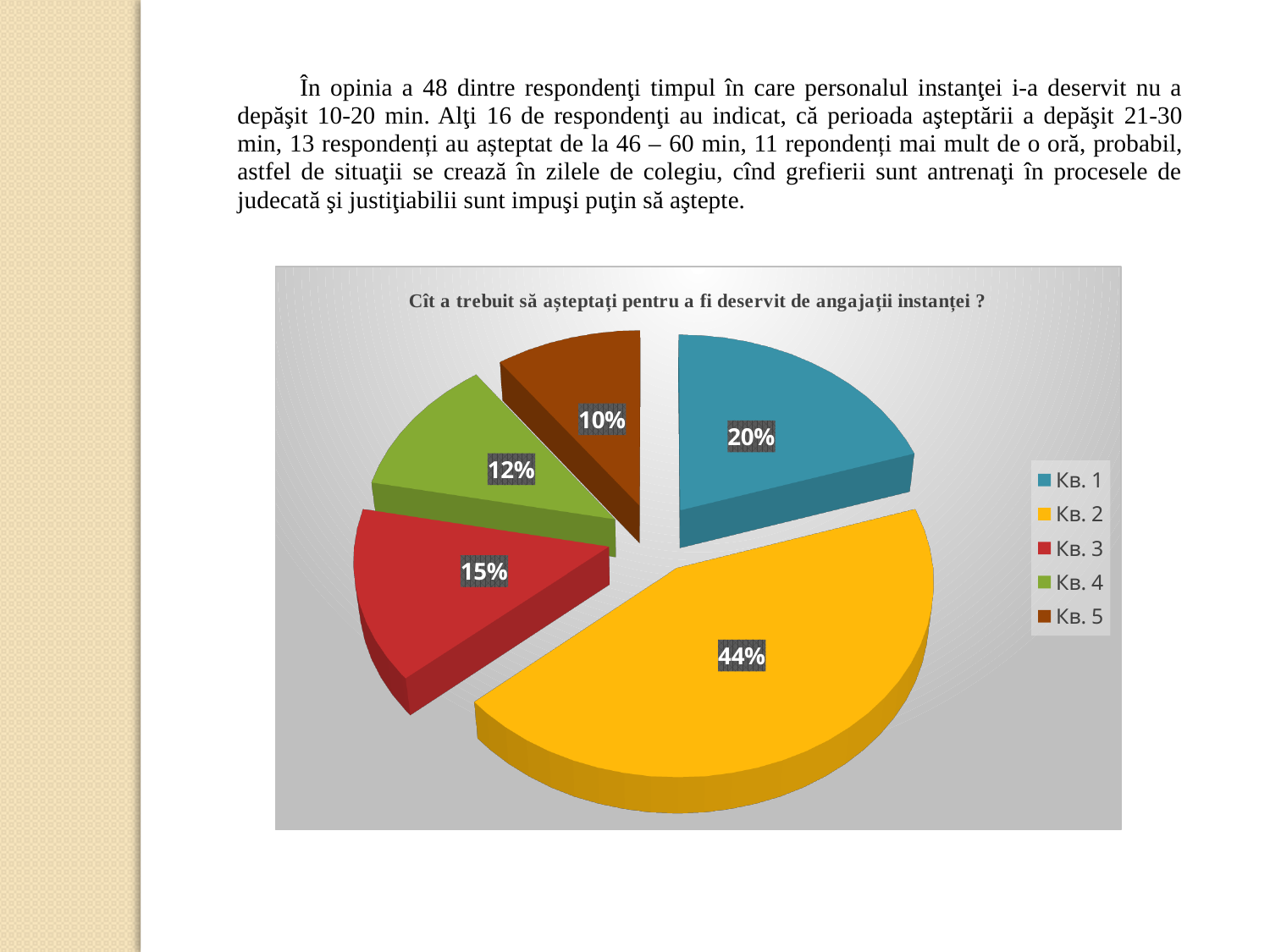
What percentage is shown for Кв. 2? 44% Which category has the smallest share of the pie? Кв. 5 Which category has the largest share of the pie? Кв. 2 What percentage is shown for Кв. 5? 10% How many entries does the legend list? 5 What is the title of the chart? Cît a trebuit să așteptați pentru a fi deservit de angajații instanței ? What is the difference in percentage points between Кв. 2 and Кв. 1? 24 What percentage is shown for Кв. 3? 15% Which is larger, the share for Кв. 3 or the share for Кв. 4? Кв. 3 What type of chart is shown on the slide? pie chart What percentage is shown for Кв. 1? 20% How many slices does the pie chart have? 5